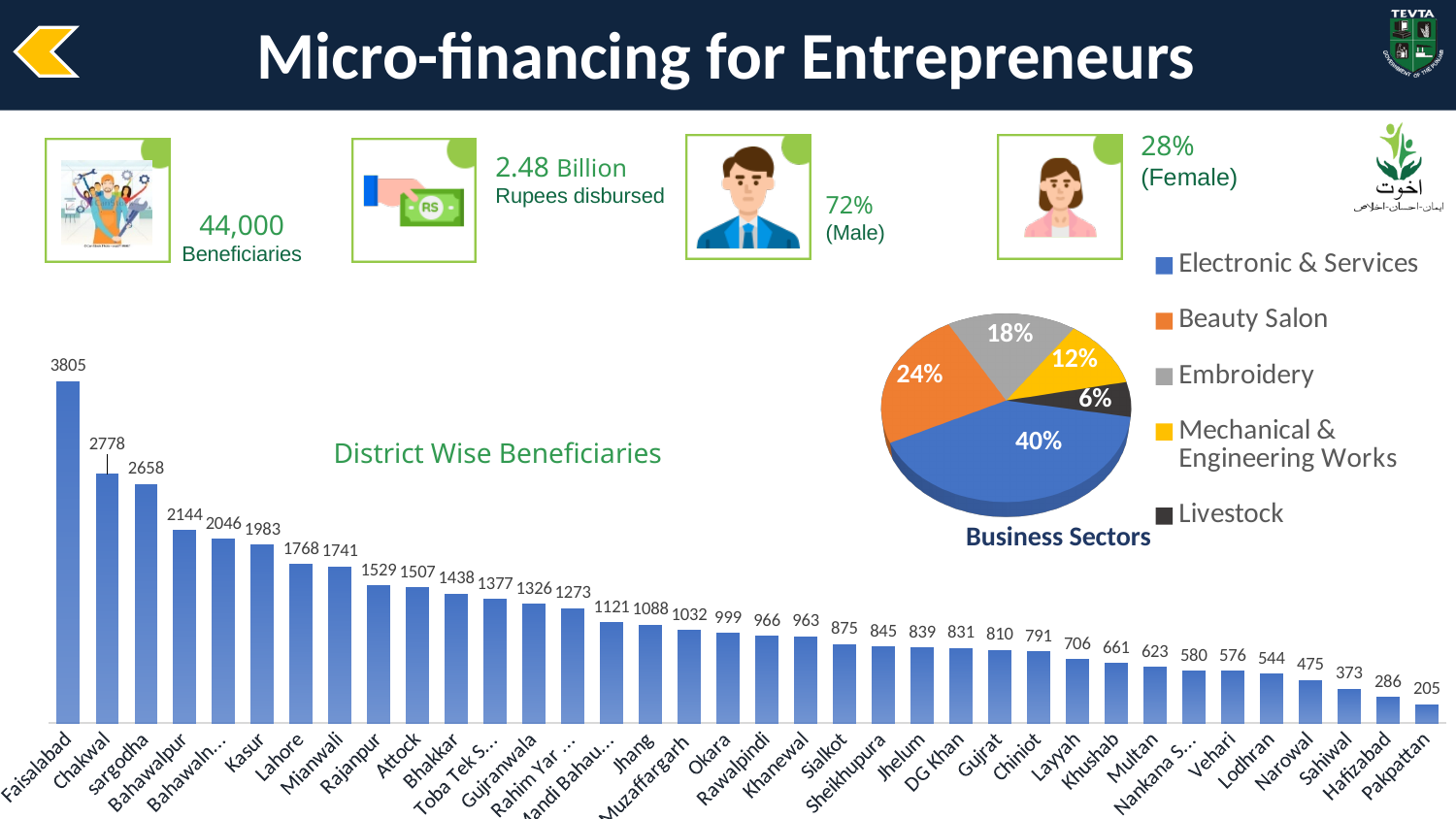
In the District Wise Beneficiaries chart, what is the value for Lahore? 1768 In the Business Sectors pie chart, which sector has the largest share? Electronic & Services In the District Wise Beneficiaries chart, what is the value for Faisalabad? 3805 In the District Wise Beneficiaries chart, which is larger, Sialkot or Multan? Sialkot In the District Wise Beneficiaries chart, which district has the lowest value? Pakpattan How many sectors does the legend of the Business Sectors pie chart list? 5 What kind of chart is the District Wise Beneficiaries chart? Bar chart In the District Wise Beneficiaries chart, which district has the highest value? Faisalabad In the Business Sectors pie chart, what share does Livestock have? 6% In the District Wise Beneficiaries chart, what is the difference between Chakwal and Kasur? 795 In the Business Sectors pie chart, what share does Beauty Salon have? 24% In the District Wise Beneficiaries chart, what is the value for Gujrat? 810